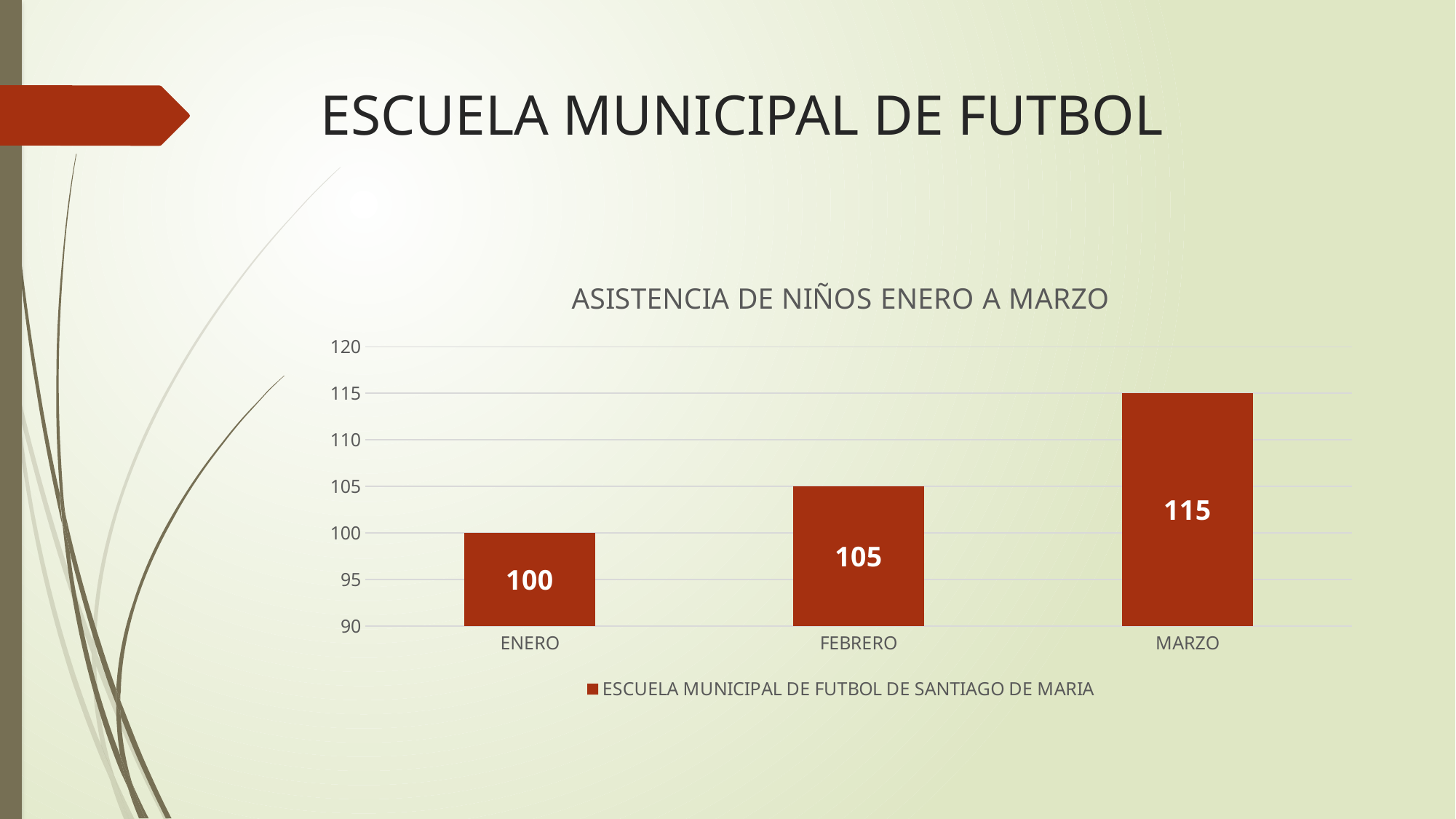
What is the difference between the values for MARZO and ENERO? 15 Which month has the lowest attendance? ENERO Is the value for MARZO greater or less than 110? greater What is the difference between the values for FEBRERO and ENERO? 5 How many months are shown on the x axis? 3 Do the values rise or fall from ENERO to MARZO? rise What is the value for MARZO? 115 What is the value for ENERO? 100 Which is larger, the value for FEBRERO or the value for MARZO? MARZO What is the value for FEBRERO? 105 Which month has the highest attendance? MARZO What kind of chart is shown? bar chart